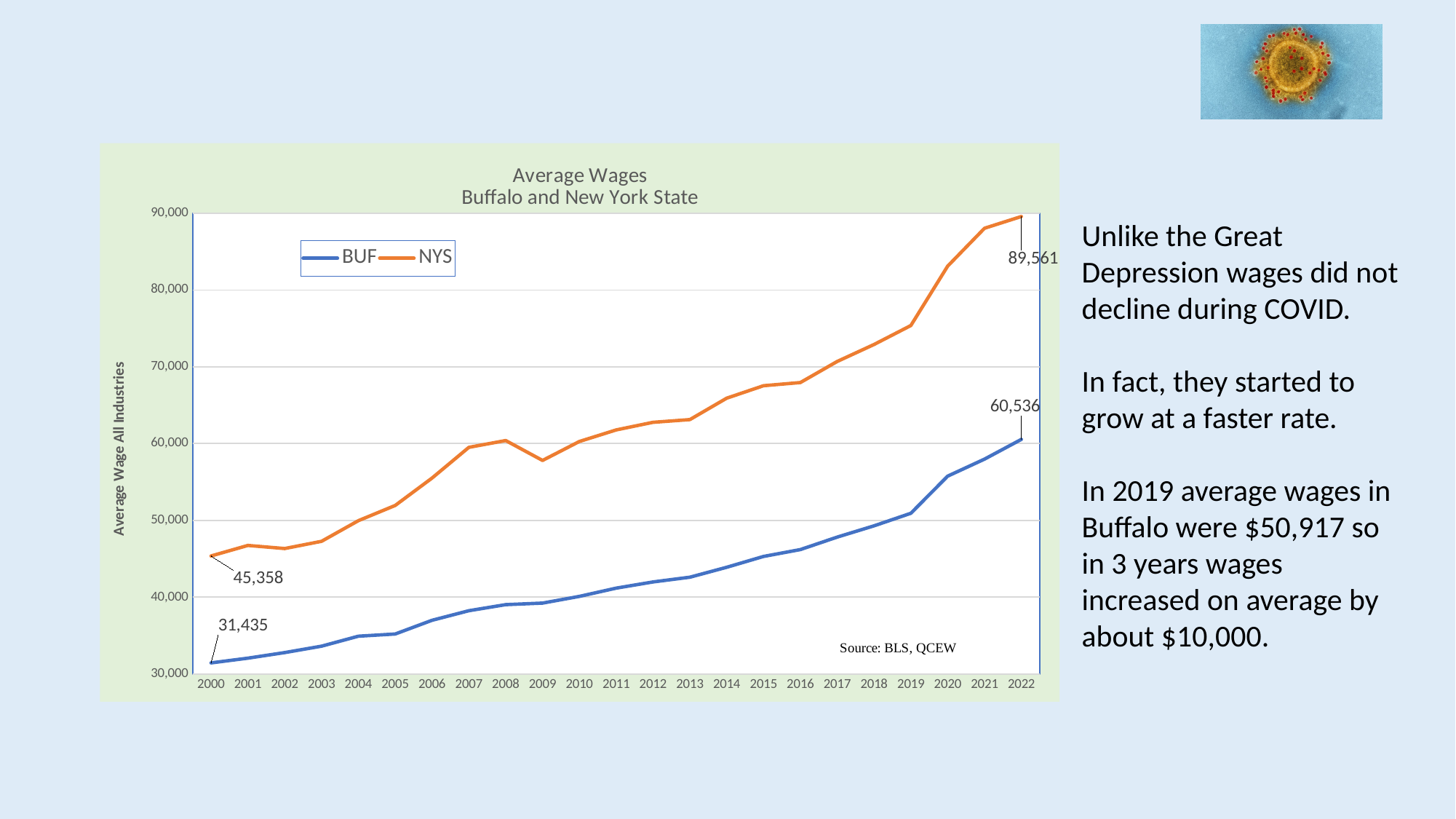
How many series does the legend list? 2 By how much did the BUF average wage increase from 2000 to 2022? 29,101 What was the average wage for BUF in 2022? 60,536 Does the BUF line generally rise or fall from 2000 to 2022? rise What was the average wage for NYS in 2000? 45,358 What was the average wage for NYS in 2022? 89,561 Which series had the higher average wage in 2022, BUF or NYS? NYS What is the difference between the NYS and BUF average wages in 2022? 29,025 How many years are plotted along the x axis? 23 Is the value for NYS in 2009 greater or less than 60,000? less What kind of chart is shown on the slide? line chart What was the average wage for BUF in 2000? 31,435